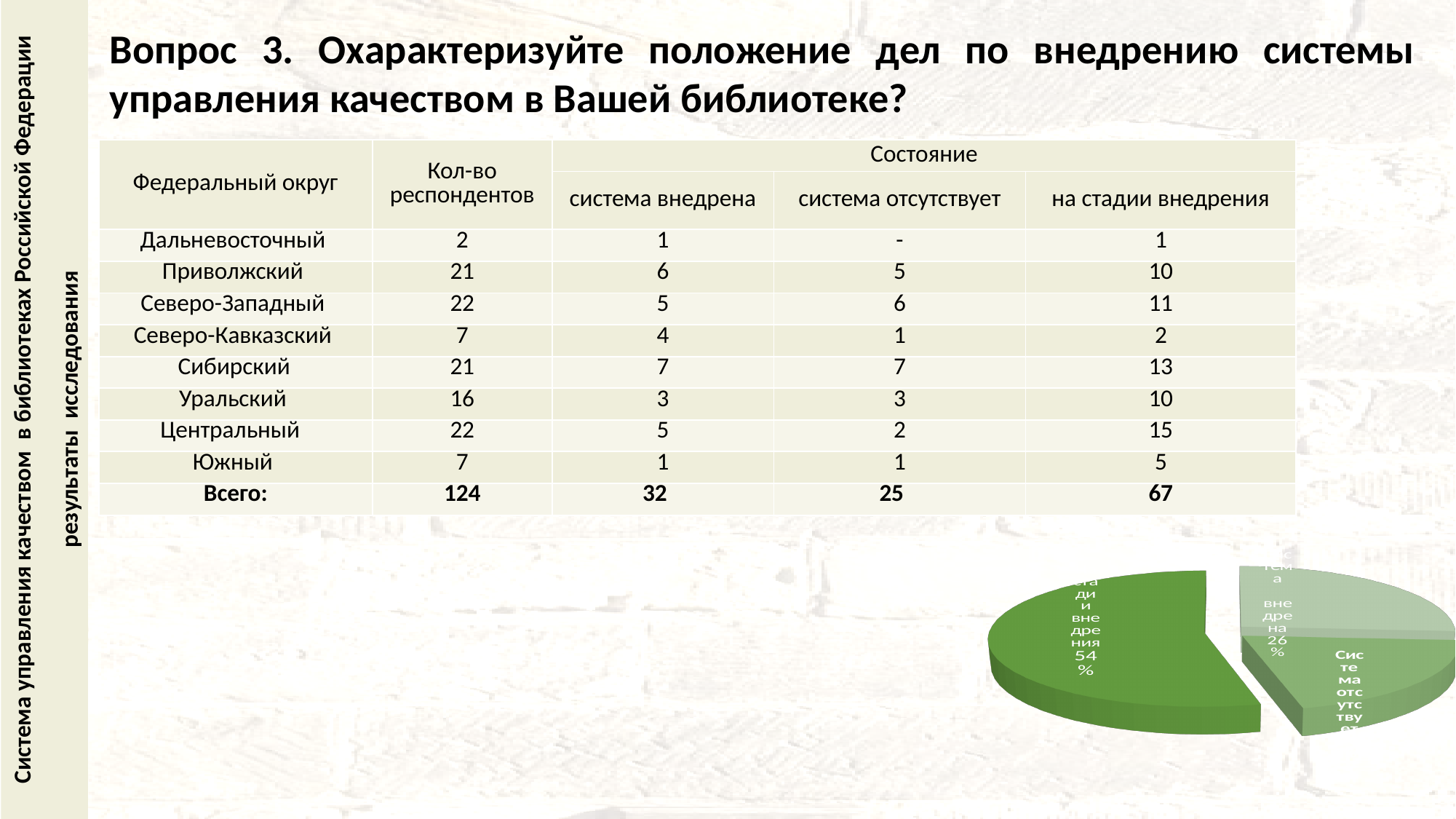
Which slice of the pie chart is the largest? на стадии внедрения In the pie chart, which slice is larger: 'на стадии внедрения' or 'Система внедрена'? на стадии внедрения In the pie chart, by how many percentage points does the 'на стадии внедрения' slice exceed the 'Система внедрена' slice? 28 Is the share of the 'на стадии внедрения' slice in the pie chart greater or less than 50%? greater What share of the pie chart does the slice 'Система внедрена' represent? 26% How many slices does the pie chart have? 3 What colour family are the slices of the pie chart drawn in? green What kind of chart is shown at the bottom right of the slide? pie chart What share of the pie chart does the slice 'на стадии внедрения' represent? 54%